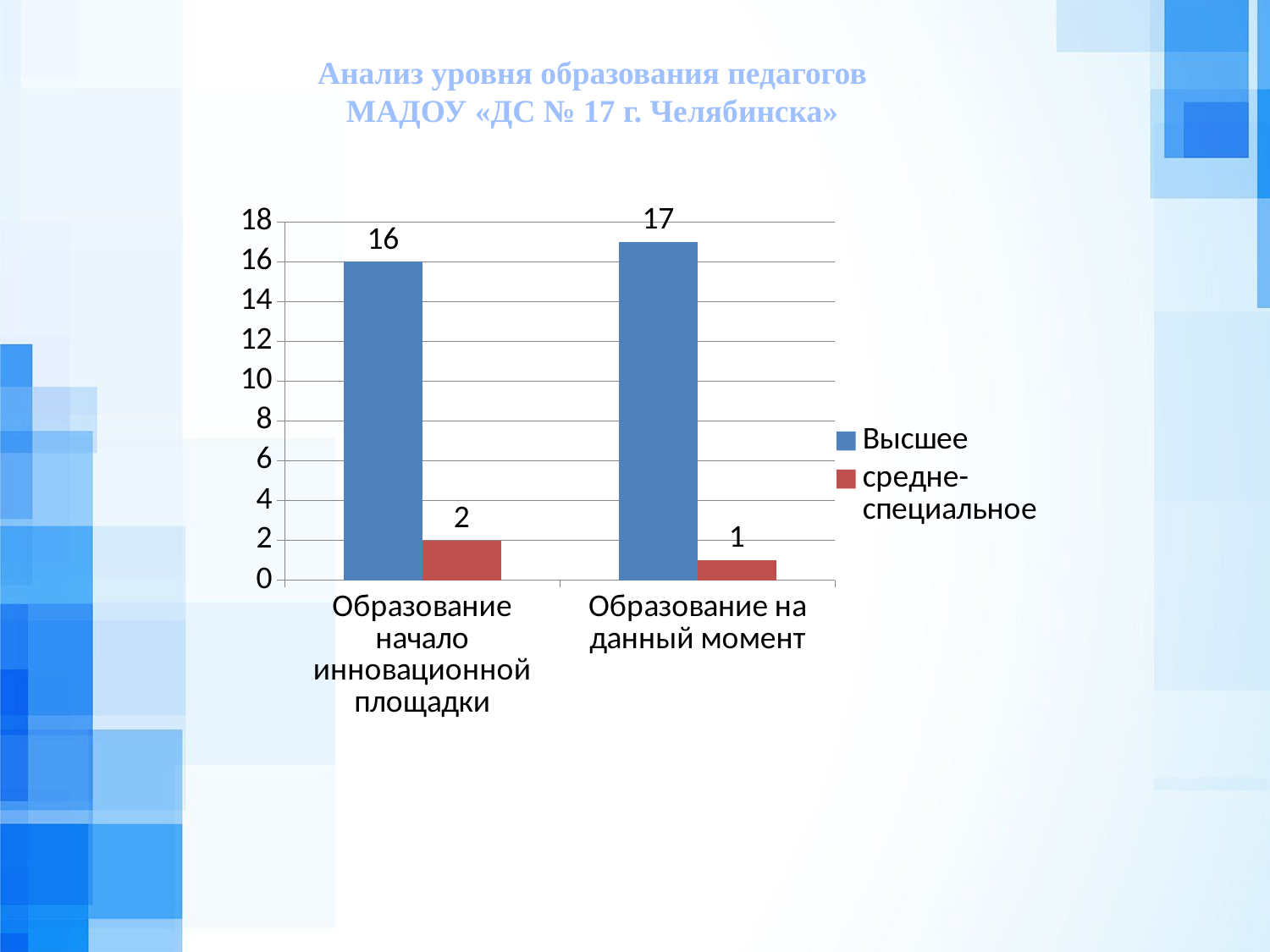
How many series does the legend list? 2 What is the value for Высшее in the category Образование на данный момент? 17 What is the value for средне-специальное in the category Образование начало инновационной площадки? 2 What is the difference between the Высшее values for Образование на данный момент and Образование начало инновационной площадки? 1 What is the value for Высшее in the category Образование начало инновационной площадки? 16 What is the value for средне-специальное in the category Образование на данный момент? 1 Which is larger in the category Образование начало инновационной площадки: Высшее or средне-специальное? Высшее Which colour represents the series Высшее in the chart? blue What kind of chart is shown on the slide? bar chart In which category is the value for Высшее highest? Образование на данный момент How many categories are shown on the x axis? 2 In which category is the value for средне-специальное lowest? Образование на данный момент